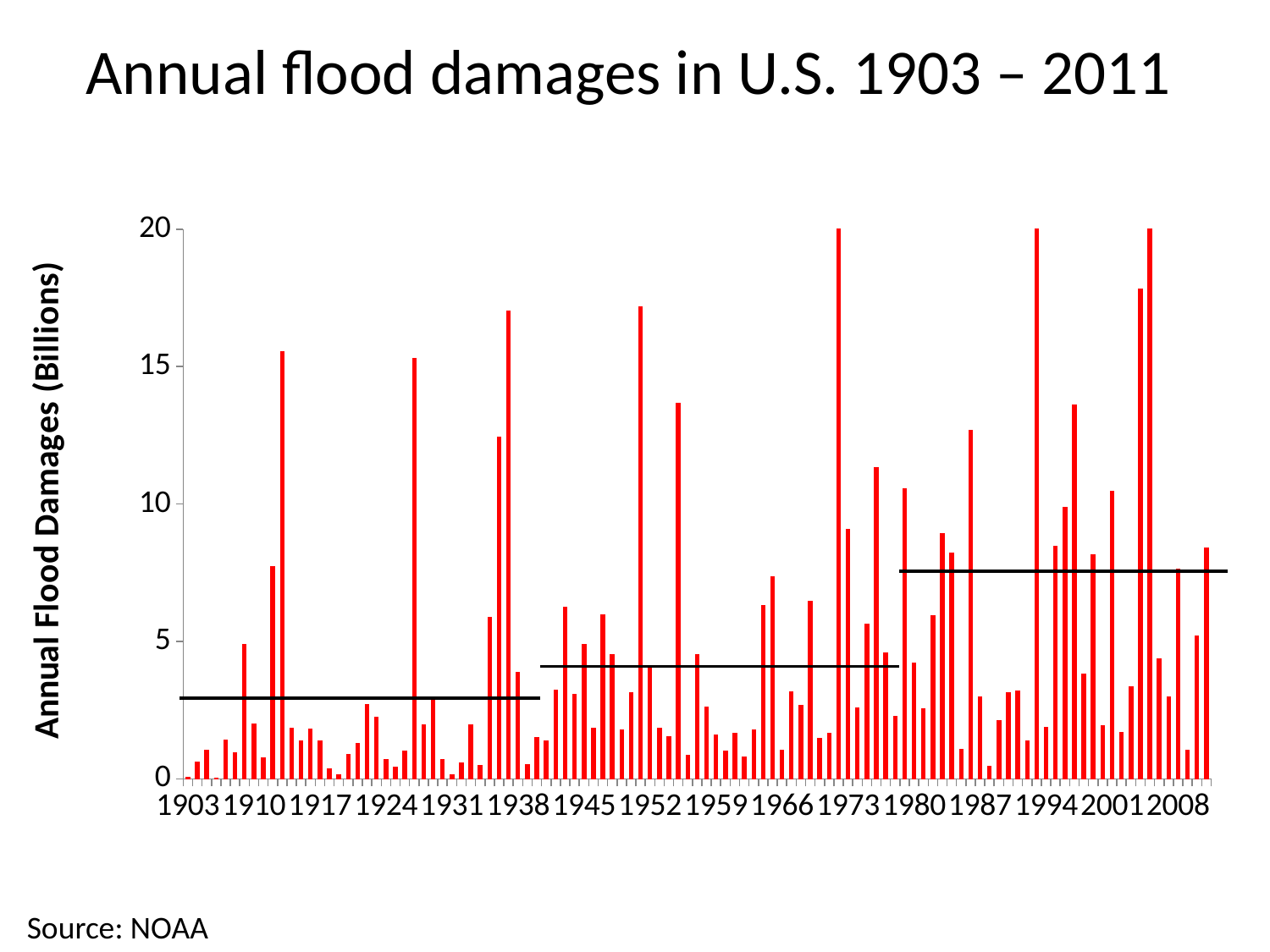
Is the value for 1931 greater or less than 5? less Do the horizontal black lines drawn across the chart rise or fall from left to right over the three periods? rise What is the title of the chart? Annual flood damages in U.S. 1903 – 2011 Is the value for 1959 greater or less than 5? less What kind of chart is shown on the slide? Bar chart Is the value for 1973 greater or less than 5? greater What is the highest value shown on the vertical axis? 20 What is the label on the vertical axis of the chart? Annual Flood Damages (Billions)